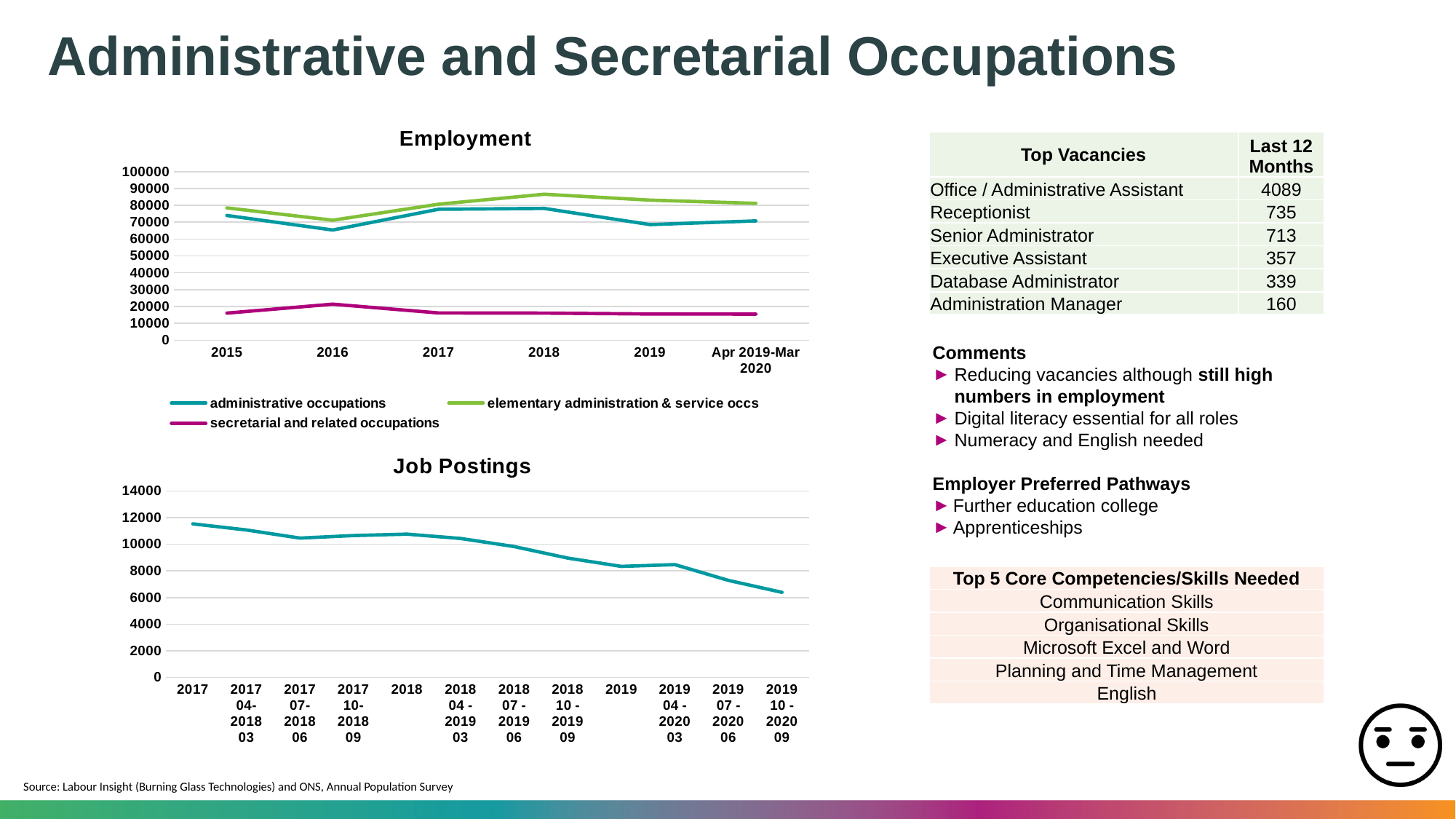
In the Employment chart, which series has the lowest values across all periods? secretarial and related occupations In the Employment chart, is the value for elementary administration & service occs in 2018 greater or less than 80000? greater In the Employment chart, which series has the highest value in 2018? elementary administration & service occs How many series does the legend of the Employment chart list? 3 What kind of chart is the Job Postings chart? line chart In the Employment chart, is the value for secretarial and related occupations in 2019 greater or less than 20000? less How many time periods are plotted in the Job Postings chart? 12 How many time periods are shown on the x axis of the Employment chart? 6 In the Job Postings chart, is the value for 2019 10 - 2020 09 greater or less than 8000? less What kind of chart is the Employment chart? line chart In the Employment chart, is the value for administrative occupations larger in 2016 or in 2017? 2017 In the Job Postings chart, do the values generally rise or fall from 2017 to 2019 10 - 2020 09? fall